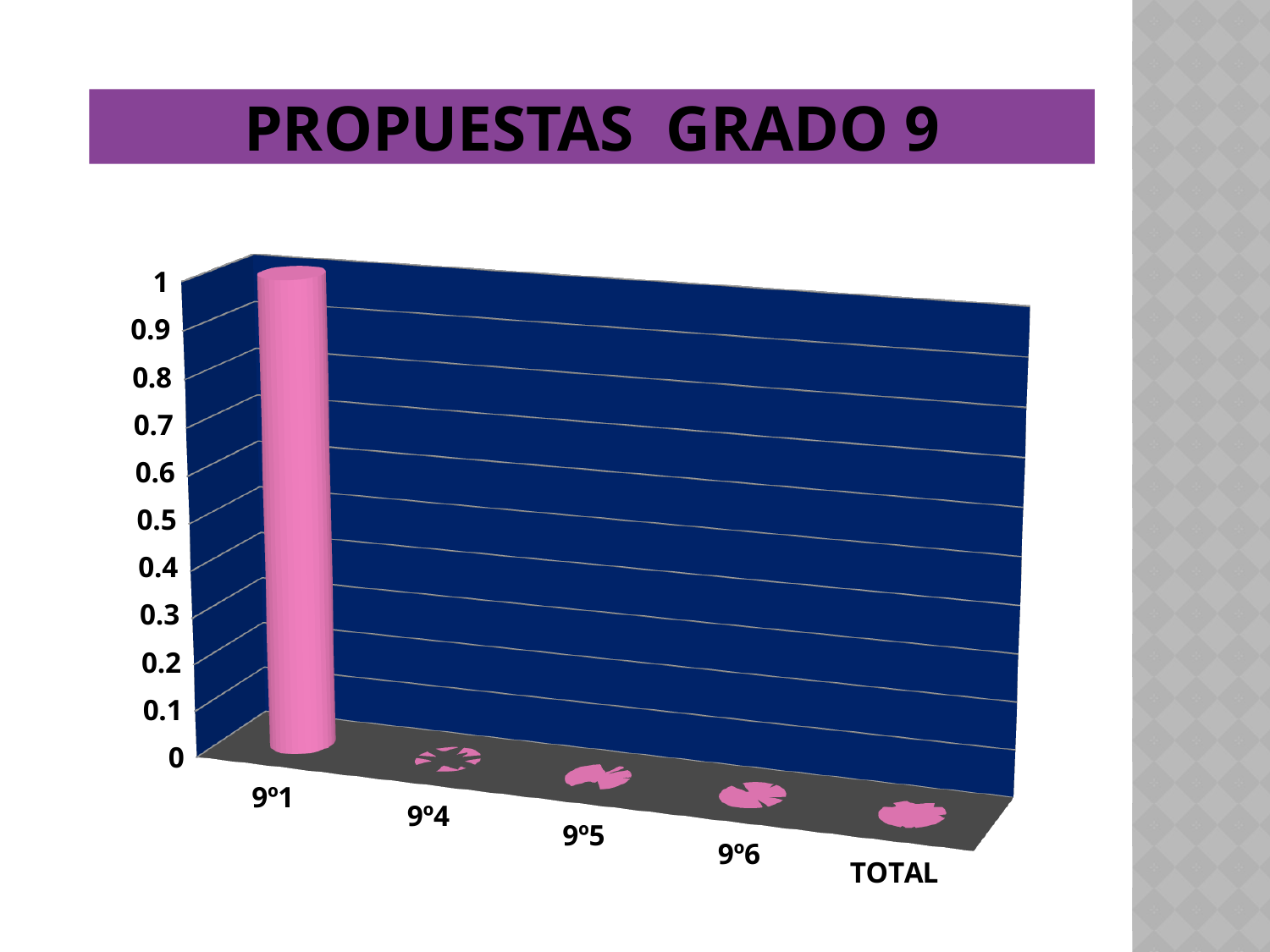
What is the value for 9º4? 0 What is the value for TOTAL? 0 What kind of chart is shown on the slide? bar chart Is the value for 9º5 greater or less than 0.1? less What is the value for 9º1? 1 What is the title of the chart? PROPUESTAS GRADO 9 Which category has the highest value in the chart? 9º1 Which is larger, the value for 9º1 or the value for 9º6? 9º1 Is the value for 9º1 greater or less than 0.5? greater What is the difference between the value for 9º1 and the value for 9º4? 1 How many categories are shown on the x axis of the chart? 5 What is the highest value shown on the vertical axis of the chart? 1